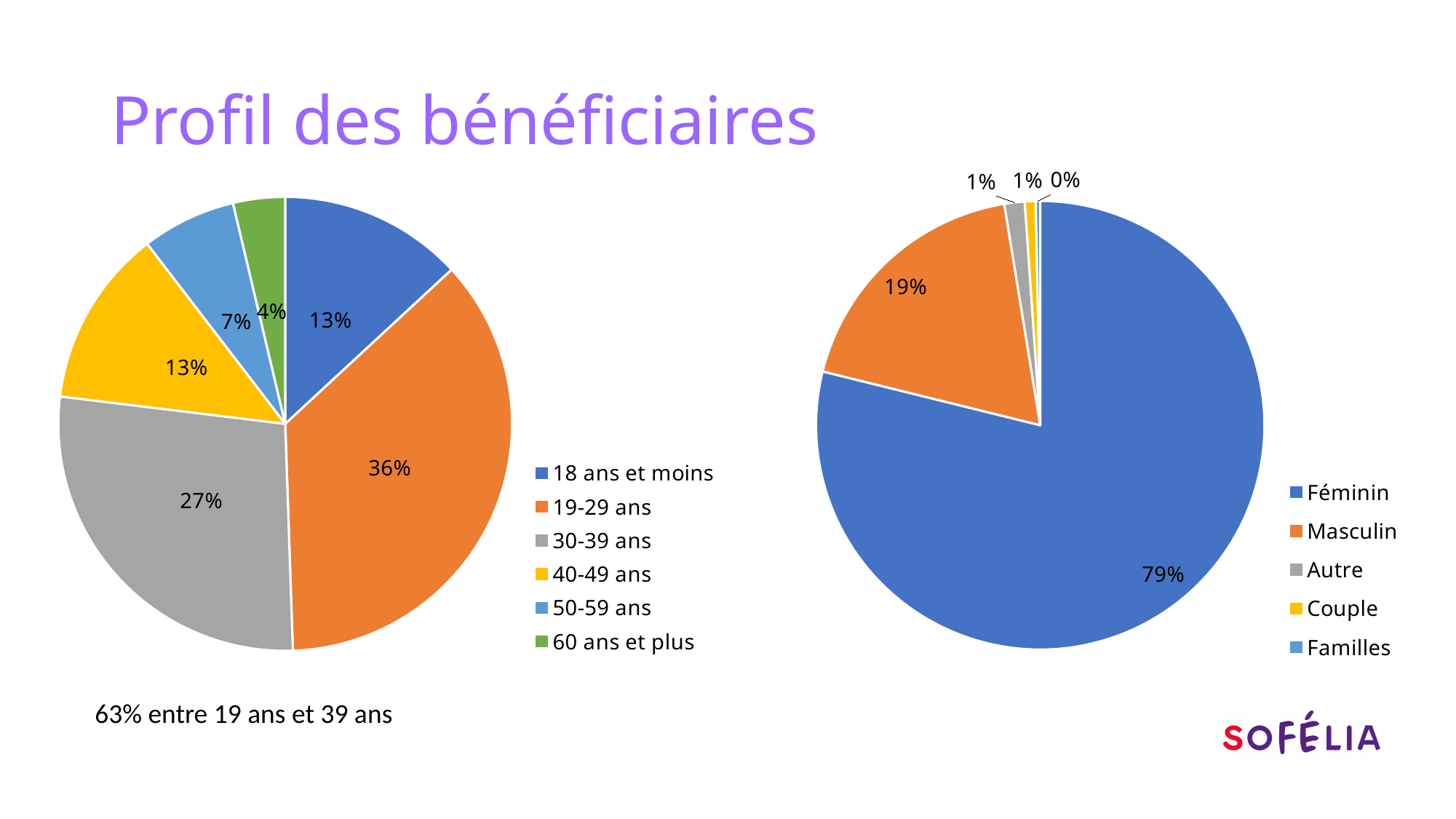
How many categories does the legend of the left pie chart list? 6 In the left pie chart, what share do the 19-29 ans have? 36% In the left pie chart, what share do the 30-39 ans have? 27% In the right pie chart, which category has the largest share? Féminin How many categories does the legend of the right pie chart list? 5 In the right pie chart, what share is Féminin? 79% In the left pie chart, what is the difference between the shares of 19-29 ans and 30-39 ans? 9% What type of chart is the left chart on the slide? pie chart In the left pie chart, which age group has the smallest share? 60 ans et plus In the right pie chart, what share is Masculin? 19% In the left pie chart, which age group has the largest share? 19-29 ans In the left pie chart, what share do the 50-59 ans have? 7%